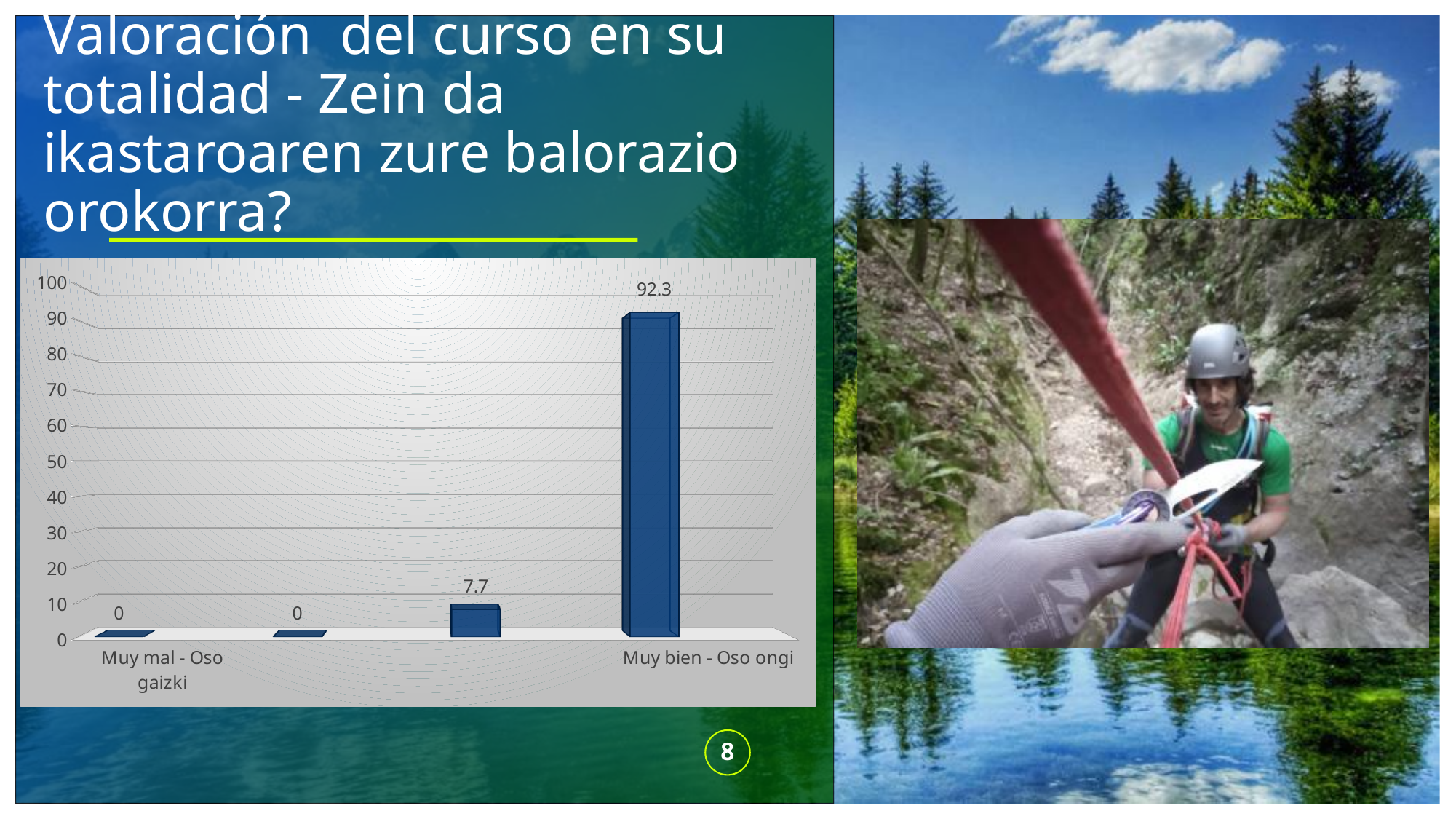
What value is shown for "Muy bien - Oso ongi"? 92.3 What value is labelled on the third bar from the left? 7.7 What kind of chart is shown on the slide? bar chart Is the value for "Muy bien - Oso ongi" greater or less than 90? greater How many bars have a value of 0? 2 Which is larger: the value for "Muy bien - Oso ongi" or the value for "Muy mal - Oso gaizki"? Muy bien - Oso ongi How many bars are plotted in the chart? 4 What is the difference between the value for "Muy bien - Oso ongi" and the value labelled on the third bar from the left? 84.6 Do the values rise or fall from left to right along the x axis? rise What value is shown for "Muy mal - Oso gaizki"? 0 What is the highest value shown on the vertical axis? 100 Which category has the highest value? Muy bien - Oso ongi